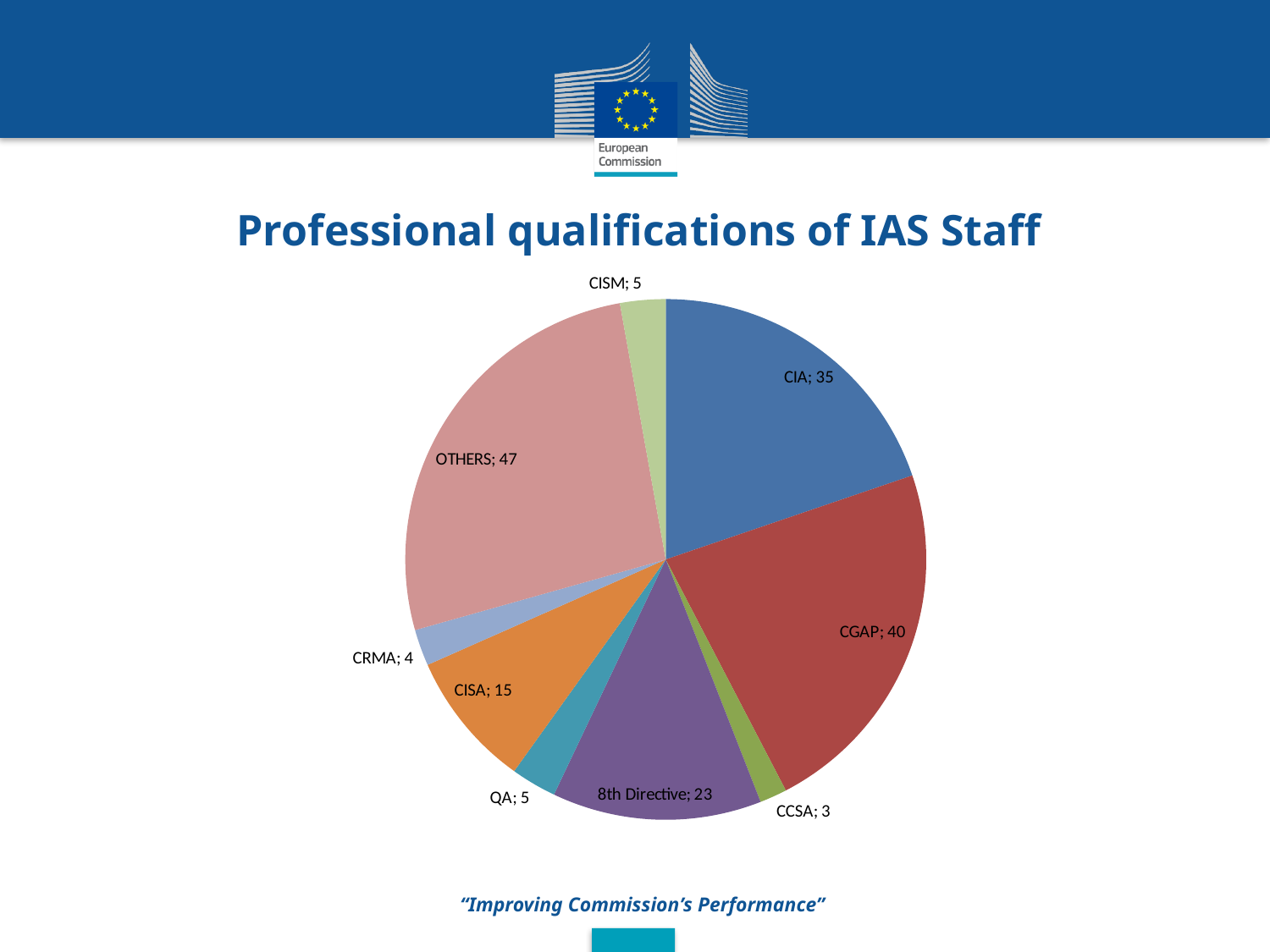
What is the difference between the values for CGAP and CIA? 5 What is the value for CRMA? 4 Which category has the largest slice? OTHERS What is the title of the chart? Professional qualifications of IAS Staff What is the value for CGAP? 40 What kind of chart is shown on the slide? pie chart Which category has the smallest slice? CCSA Which is larger, the value for CISA or the value for 8th Directive? 8th Directive How many slices does the pie chart have? 9 What is the total of all the values shown in the pie chart? 177 What is the value for 8th Directive? 23 What is the value for CISA? 15